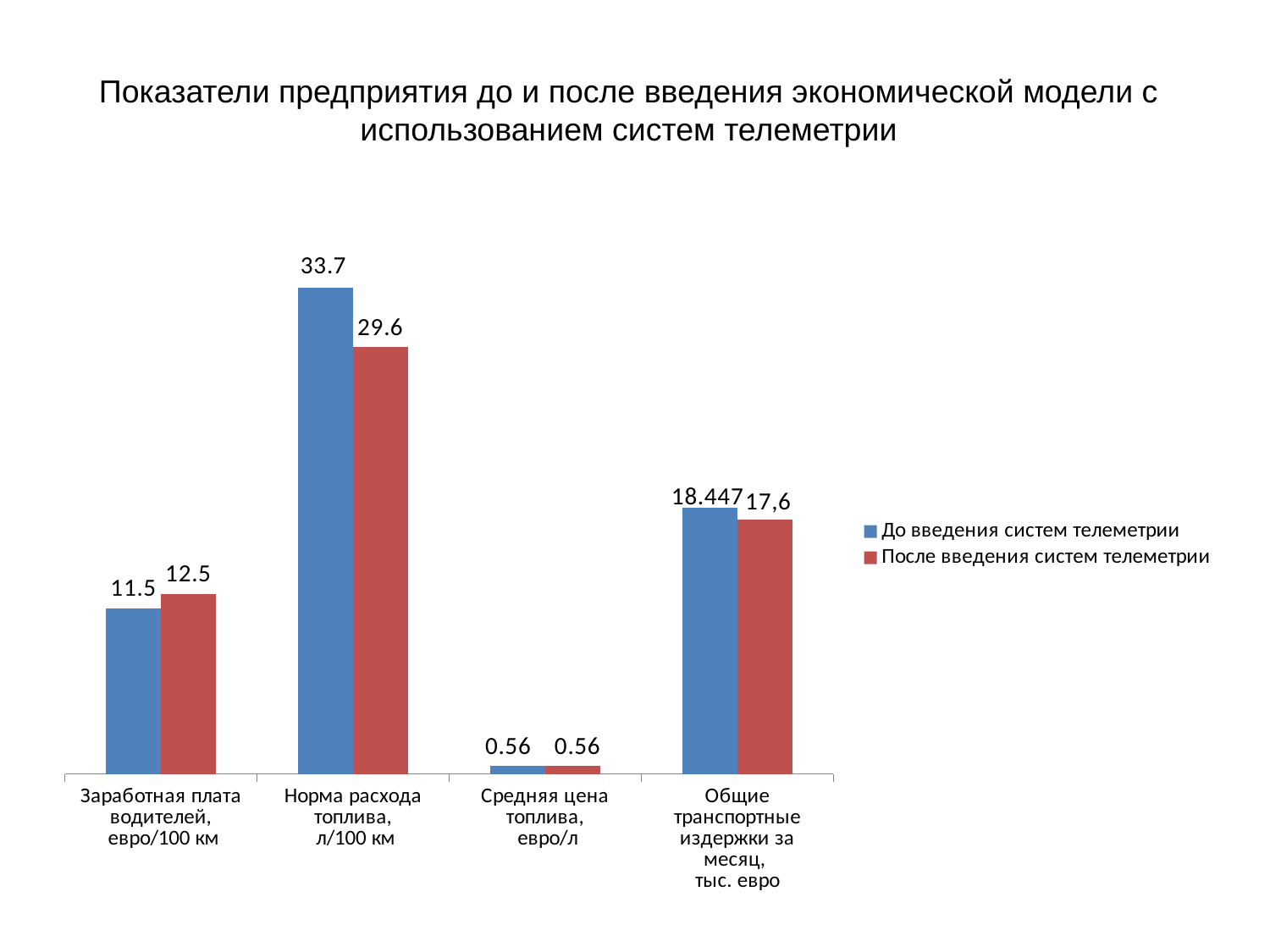
Which category has the lowest value in the 'После введения систем телеметрии' series? Средняя цена топлива, евро/л What is the value for 'Общие транспортные издержки за месяц, тыс. евро' in the 'До введения систем телеметрии' series? 18.447 What is the difference between the 'До введения' and 'После введения' values for 'Норма расхода топлива, л/100 км'? 4.1 How many series does the legend list? 2 What is the value for 'Общие транспортные издержки за месяц, тыс. евро' in the 'После введения систем телеметрии' series? 17,6 What kind of chart is shown on the slide? Bar chart How many categories are shown on the x axis of the chart? 4 What is the value for 'Заработная плата водителей, евро/100 км' after the introduction of telemetry systems ('После введения систем телеметрии')? 12.5 Which category has the highest value in the 'До введения систем телеметрии' series? Норма расхода топлива, л/100 км What is the value for 'Норма расхода топлива, л/100 км' in the 'До введения систем телеметрии' series? 33.7 What is the value for 'Норма расхода топлива, л/100 км' in the 'После введения систем телеметрии' series? 29.6 For 'Заработная плата водителей, евро/100 км', which series has the larger value: 'До введения систем телеметрии' or 'После введения систем телеметрии'? После введения систем телеметрии